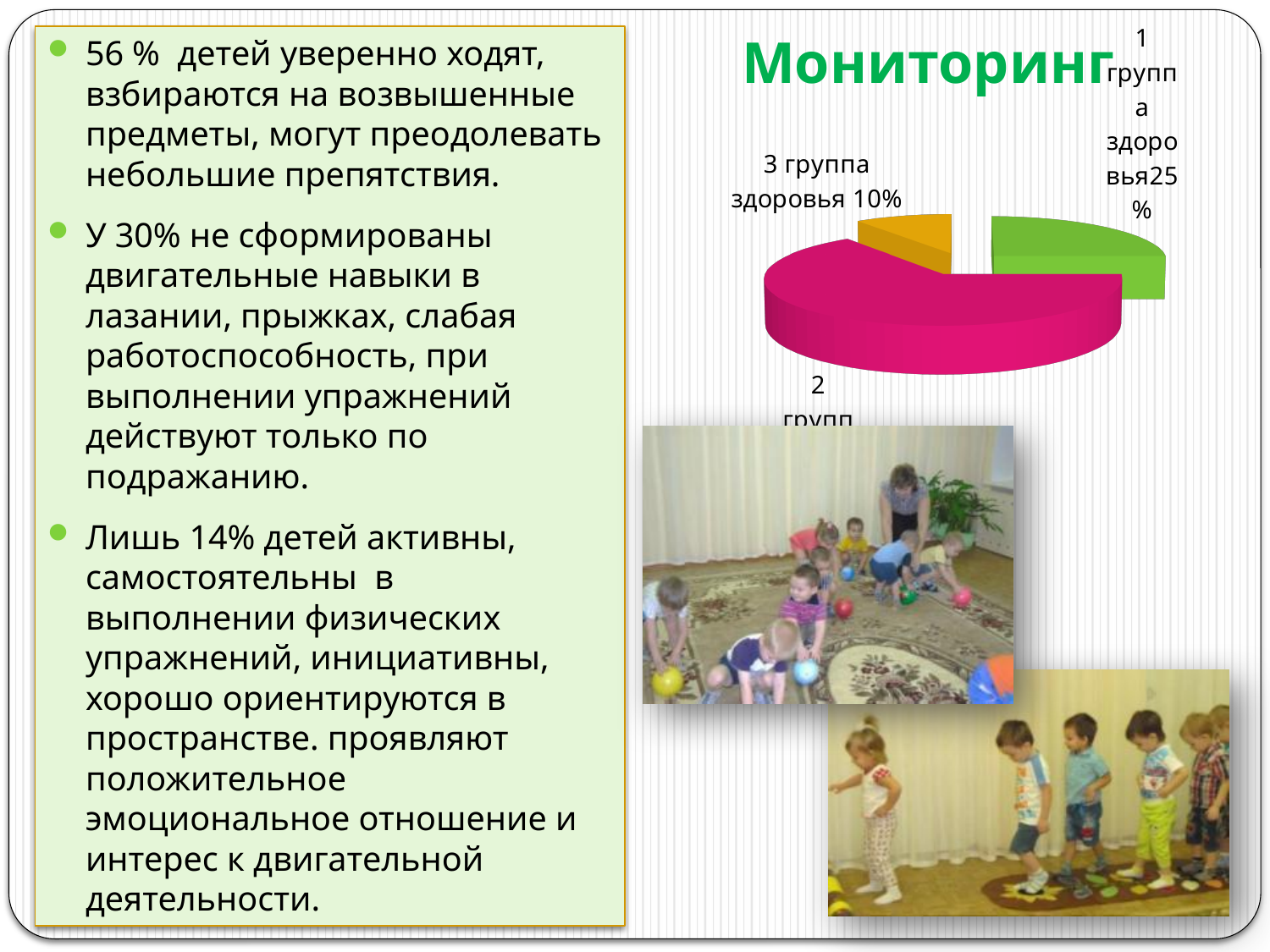
What colour is the slice for 3 группа здоровья? orange Which health group has the largest slice of the pie? 2 группа здоровья What percentage is shown for 3 группа здоровья? 10% What kind of chart is shown on the slide? pie chart What is the difference between the percentages for 1 группа здоровья and 3 группа здоровья? 15% Which health group has the smallest slice of the pie? 3 группа здоровья Which is larger, the share for 1 группа здоровья or for 3 группа здоровья? 1 группа здоровья What is the title of the chart? Мониторинг How many slices does the pie chart have? 3 What share of the pie does 1 группа здоровья take? 25% What percentage is shown for 1 группа здоровья? 25%